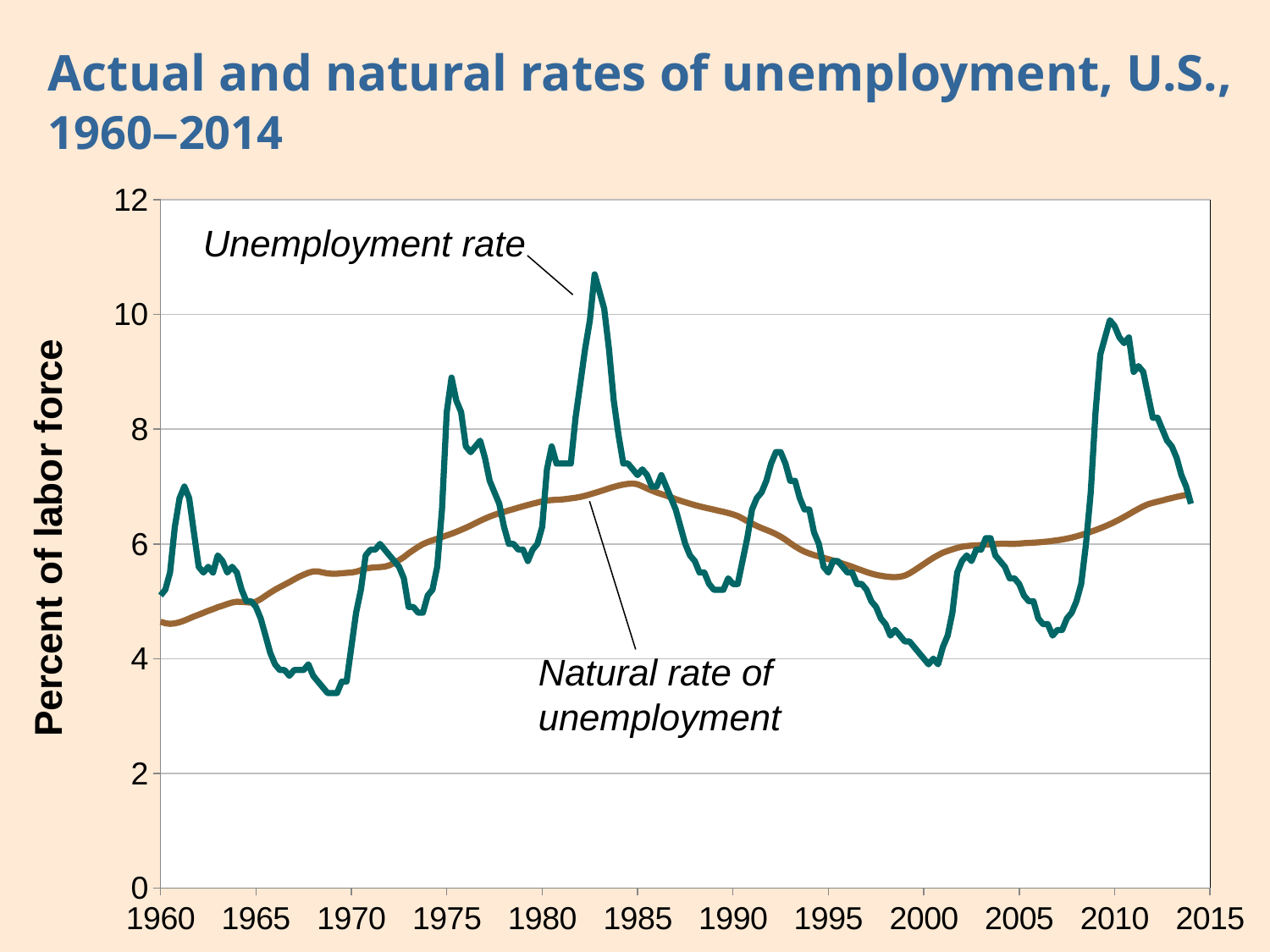
What is the title of the chart? Actual and natural rates of unemployment, U.S., 1960–2014 Which series reaches the highest value anywhere on the chart? Unemployment rate Is the natural rate of unemployment around 1985 greater or less than 6? greater Around 2000, which is larger: the unemployment rate or the natural rate of unemployment? Natural rate of unemployment Is the peak value of the unemployment rate in the early 1980s greater or less than 10? greater Does the natural rate of unemployment rise or fall between 1960 and 1985? Rise Is the unemployment rate around 1969 greater or less than 4? less What is the label on the vertical axis? Percent of labor force How many series are plotted on the chart? 2 What kind of chart is shown on the slide? Line chart Around 1983, which is larger: the unemployment rate or the natural rate of unemployment? Unemployment rate